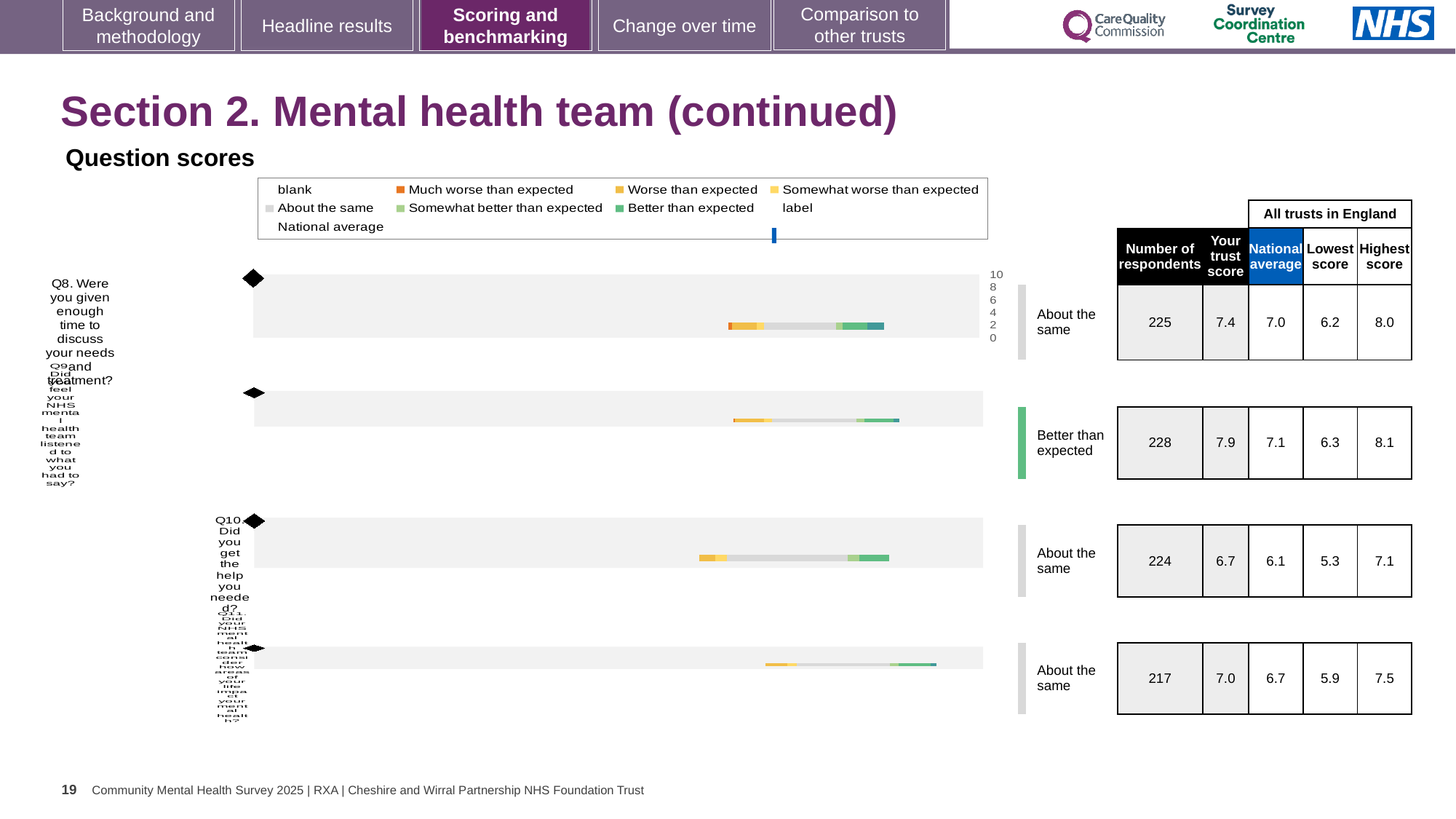
What kind of chart is used to show the question scores on this slide? bar chart For Q8, what is the difference between the trust score and the national average? 0.4 In the legend, what colour represents 'Much worse than expected'? orange For Q8 (Were you given enough time to discuss your needs and treatment?), what is the trust score shown? 7.4 What benchmark label is shown next to the Q9 chart? Better than expected Which question has the highest 'Your trust score' on this slide? Q9 For Q11, what is the highest score among all trusts in England? 7.5 For Q9 (Did you feel your NHS mental health team listened to what you had to say?), how many respondents are shown? 228 For Q10 (Did you get the help you needed?), which is larger: the trust score or the national average? the trust score How many questions (Q8 to Q11) have a score chart on this slide? 4 Which question has the lowest 'Your trust score' on this slide? Q10 For Q10, what is the lowest score among all trusts in England? 5.3